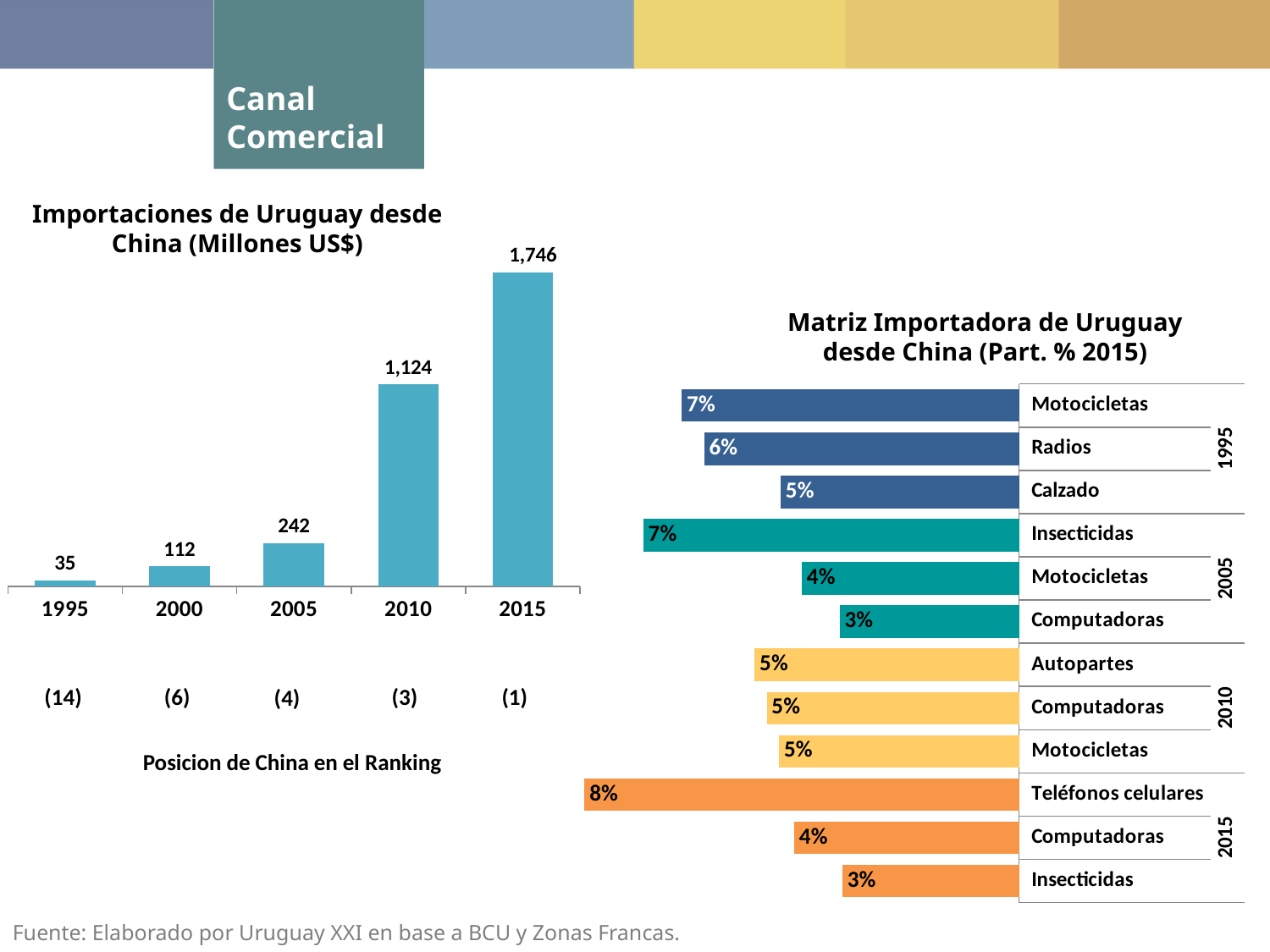
In the chart 'Matriz Importadora de Uruguay desde China (Part. % 2015)', what is the share for Radios in 1995? 6% In the chart 'Matriz Importadora de Uruguay desde China (Part. % 2015)', how many bars are plotted? 12 In the chart 'Importaciones de Uruguay desde China (Millones US$)', what is the difference between the values for 2015 and 2010? 622 In the chart 'Matriz Importadora de Uruguay desde China (Part. % 2015)', which product has the largest share? Teléfonos celulares In the chart 'Importaciones de Uruguay desde China (Millones US$)', which year has the highest value? 2015 In the chart 'Importaciones de Uruguay desde China (Millones US$)', do the values rise or fall from 1995 to 2015? rise In the chart 'Matriz Importadora de Uruguay desde China (Part. % 2015)', what is the share for Teléfonos celulares in 2015? 8% In the chart 'Importaciones de Uruguay desde China (Millones US$)', which year has the lowest value? 1995 What kind of chart is 'Importaciones de Uruguay desde China (Millones US$)'? bar chart In the chart 'Importaciones de Uruguay desde China (Millones US$)', what is the value for 2010? 1,124 In the chart 'Importaciones de Uruguay desde China (Millones US$)', how many years are plotted? 5 In the chart 'Importaciones de Uruguay desde China (Millones US$)', what is the value for 1995? 35